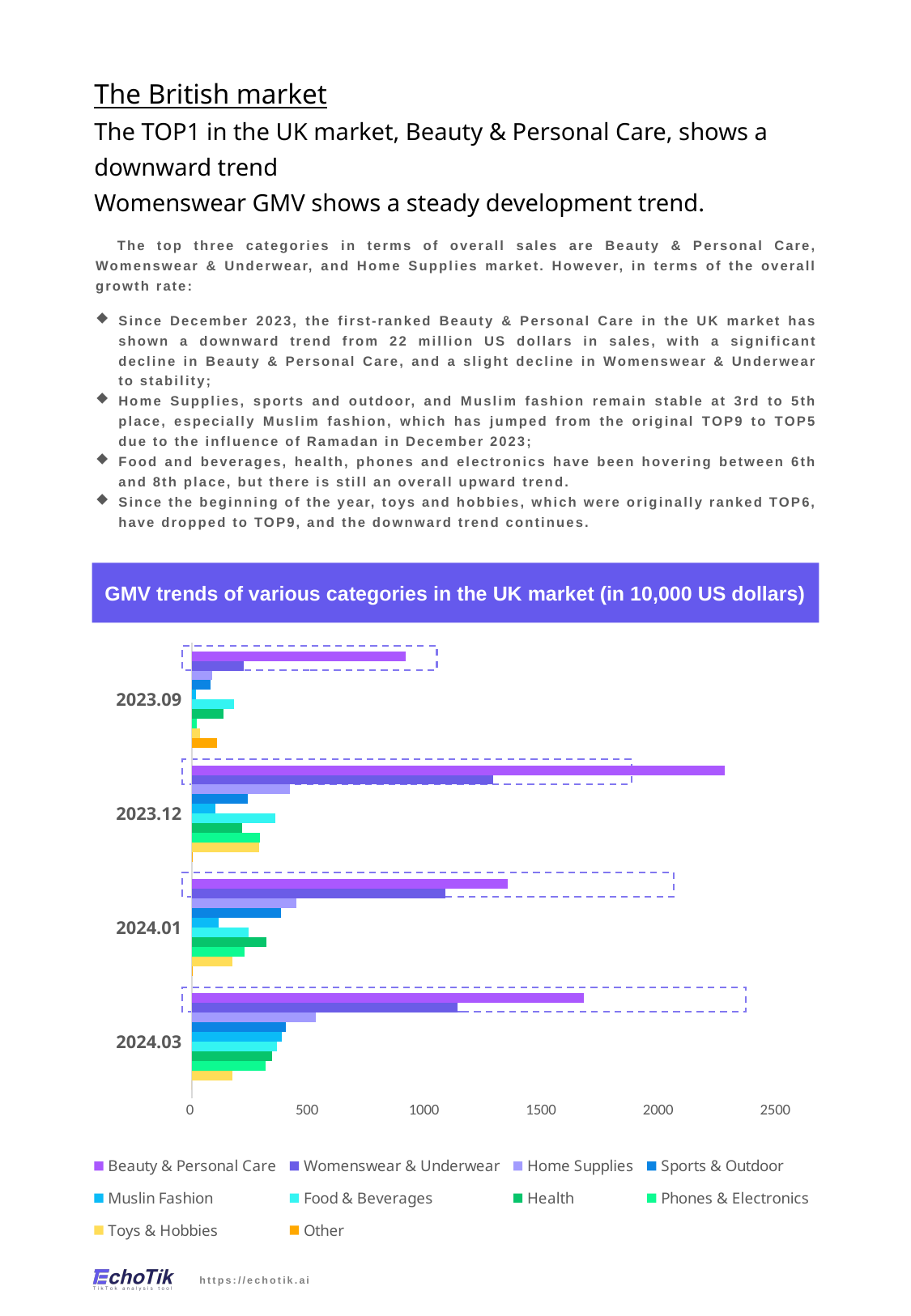
What is the title of the chart? GMV trends of various categories in the UK market (in 10,000 US dollars) Is the value for Beauty & Personal Care in 2023.09 greater or less than 1000? less Is the value for Womenswear & Underwear in 2023.12 greater or less than 1000? greater Is the value for Beauty & Personal Care in 2023.12 greater or less than 2000? greater In which period is the Beauty & Personal Care bar the longest? 2023.12 How many series does the chart's legend list? 10 How many time periods are shown on the chart's vertical axis? 4 In which period is the Beauty & Personal Care bar the shortest? 2023.09 Which is larger: Beauty & Personal Care in 2023.12 or Beauty & Personal Care in 2024.03? 2023.12 What kind of chart is shown on the slide? bar chart